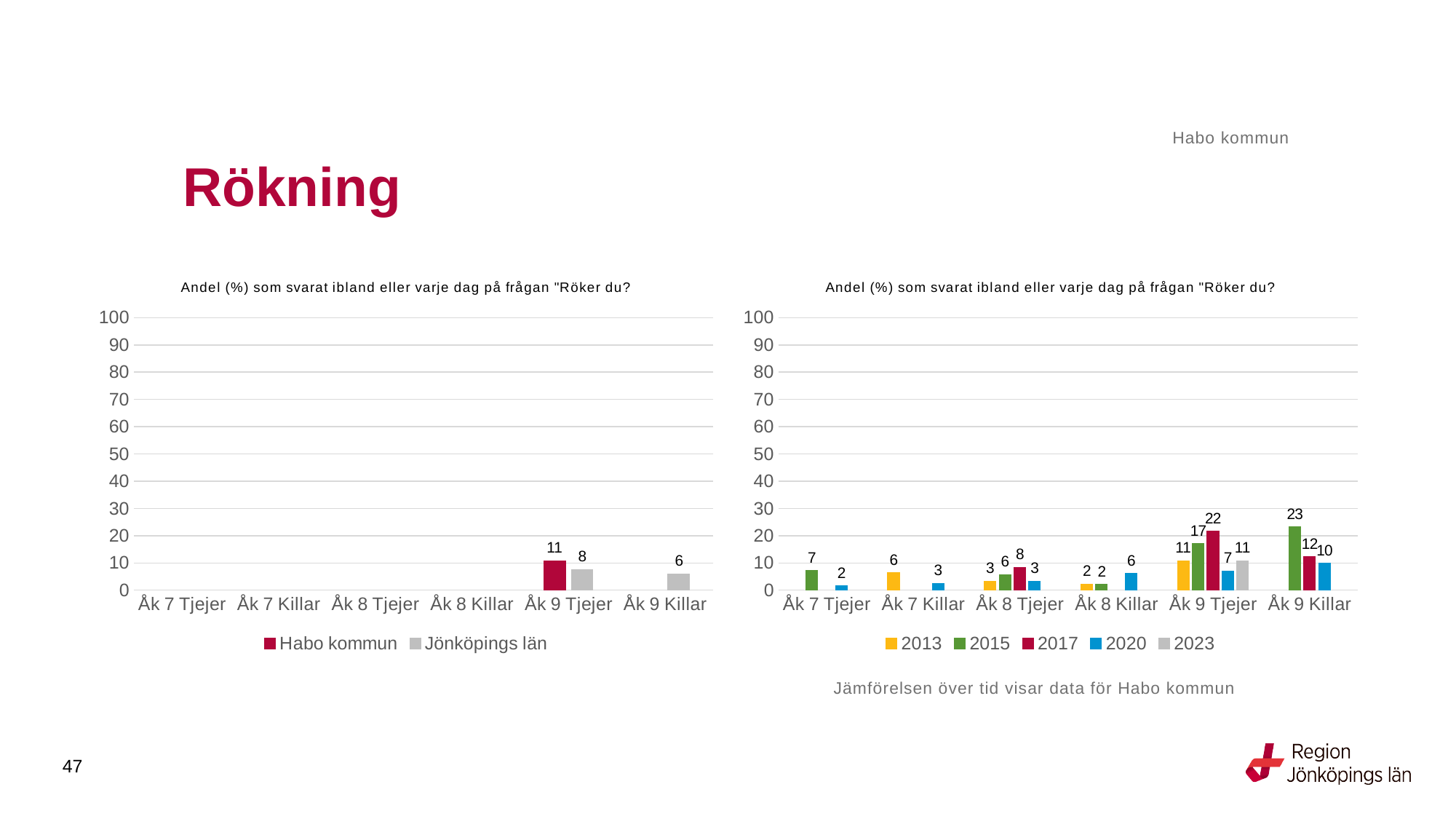
In the right chart, which is larger for Åk 8 Tjejer: the value for 2015 or the value for 2017? 2017 In the left chart, what is the value for Habo kommun for Åk 9 Tjejer? 11 In the left chart, what is the difference between Habo kommun and Jönköpings län for Åk 9 Tjejer? 3 In the right chart, what is the difference between 2015 and 2017 for Åk 9 Killar? 11 In the right chart, how many series does the legend list? 5 In the right chart, which year has the lowest value for Åk 9 Tjejer? 2020 In the left chart, how many series does the legend list? 2 What kind of chart is the right chart? Bar chart In the right chart, what is the value for 2015 for Åk 9 Killar? 23 In the right chart, which year has the highest value for Åk 9 Tjejer? 2017 In the left chart, what is the value for Jönköpings län for Åk 9 Killar? 6 In the right chart, what is the value for 2017 for Åk 9 Tjejer? 22